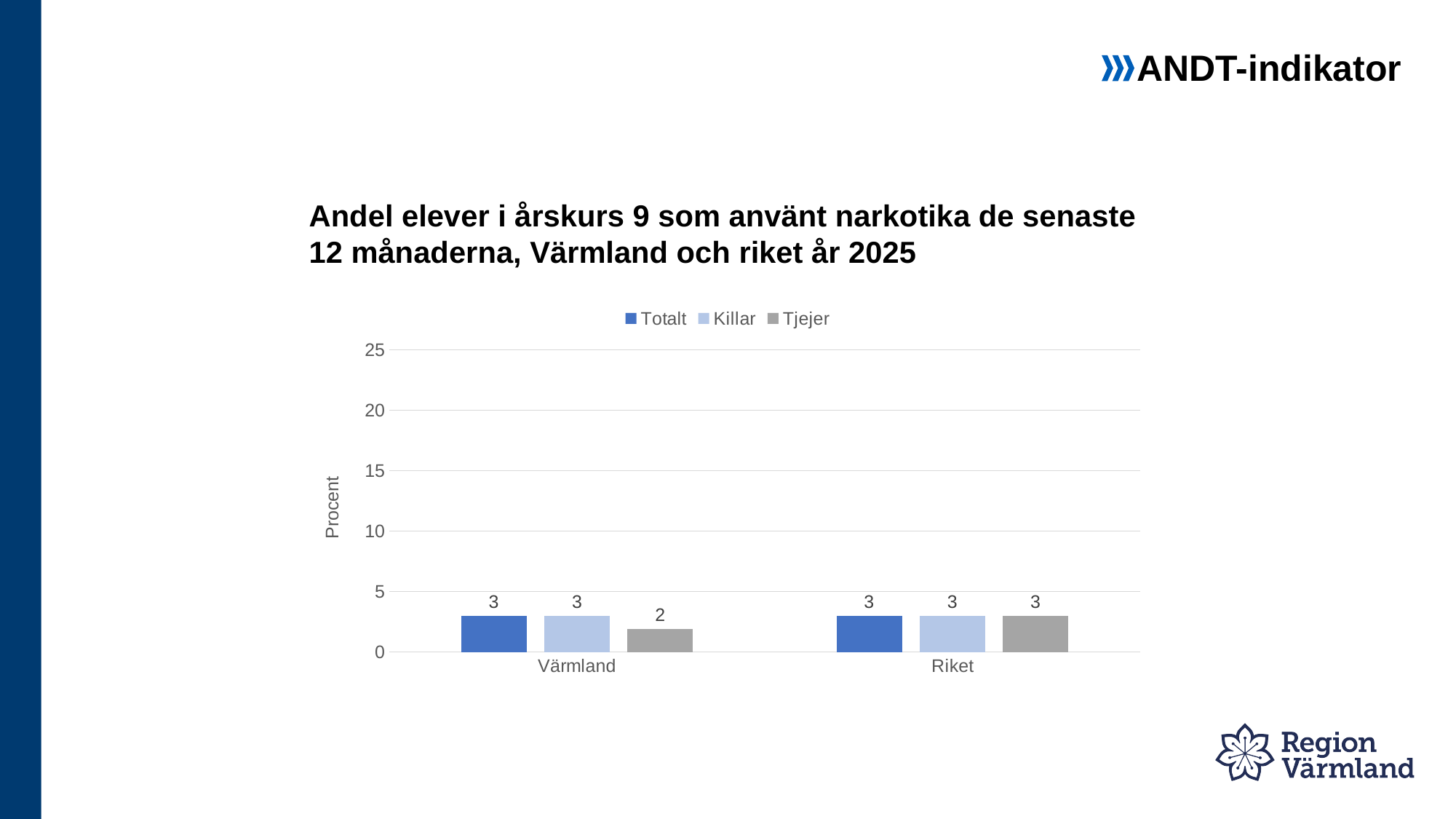
What is the value for Totalt in Riket? 3 Which series has the lowest value in Värmland? Tjejer How many categories are shown on the x axis? 2 Which is larger, the Tjejer value for Värmland or the Tjejer value for Riket? Riket What is the label of the y axis? Procent What is the value for Tjejer in Värmland? 2 What is the value for Tjejer in Riket? 3 How many series does the legend list? 3 What is the difference between the Tjejer value for Riket and the Tjejer value for Värmland? 1 What is the value for Killar in Värmland? 3 Is the value for Totalt in Värmland greater or less than 5? less What kind of chart is shown on the slide? bar chart